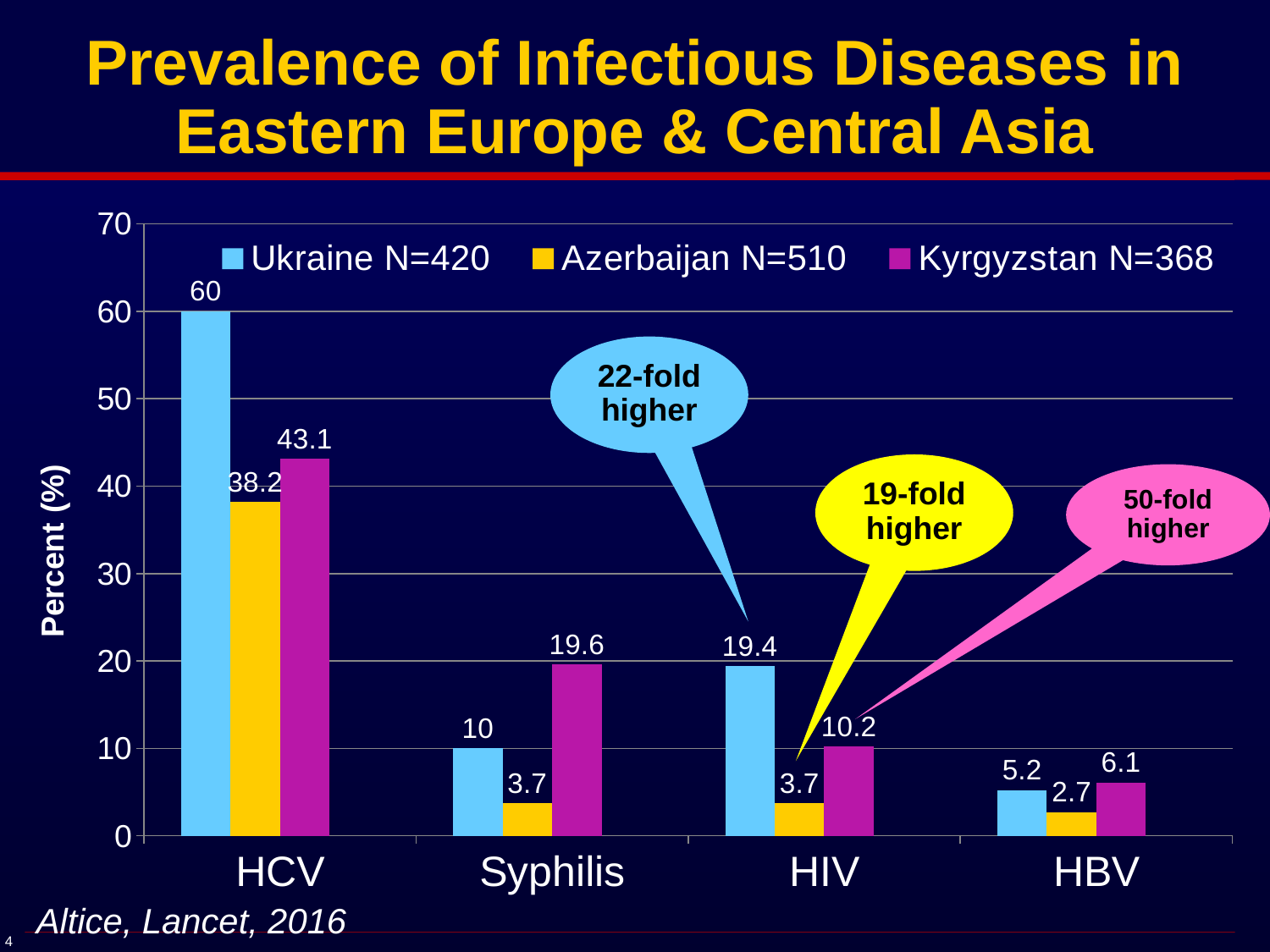
What is the label of the y axis? Percent (%) How many series does the legend list? 3 Which disease has the highest prevalence for Ukraine N=420? HCV What is the HBV prevalence for Azerbaijan N=510? 2.7 What is the HCV prevalence for Ukraine N=420? 60 How many disease categories are shown on the x axis? 4 Which is larger, the HIV prevalence for Ukraine N=420 or for Kyrgyzstan N=368? Ukraine N=420 What is the Syphilis prevalence for Kyrgyzstan N=368? 19.6 What is the HIV prevalence for Azerbaijan N=510? 3.7 What kind of chart is shown on the slide? Bar chart Which disease has the lowest prevalence for Kyrgyzstan N=368? HBV What is the difference between the HCV prevalence for Kyrgyzstan N=368 and Azerbaijan N=510? 4.9